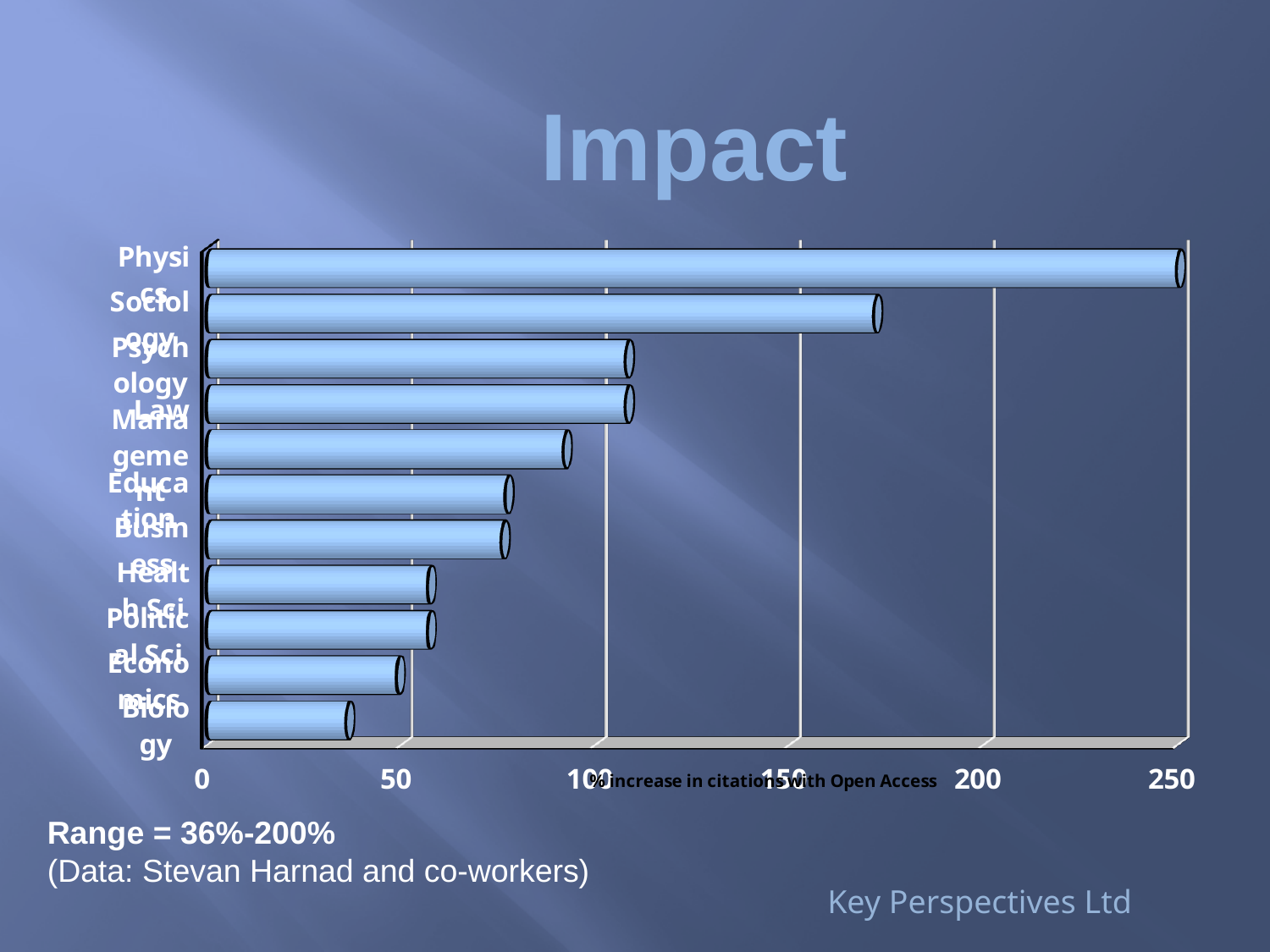
Which has a larger value, Management or Health Sci? Management Is the value for Education greater or less than 50? greater Which has a larger value, Sociology or Psychology? Sociology Is the value for Physics greater or less than 200? greater Which discipline has the highest % increase in citations with Open Access? Physics Is the value for Sociology greater or less than 150? greater How many categories (disciplines) are plotted in the chart? 11 Which discipline has the lowest % increase in citations with Open Access? Biology What is the label of the horizontal axis? % increase in citations with Open Access What kind of chart is shown on the slide? bar chart